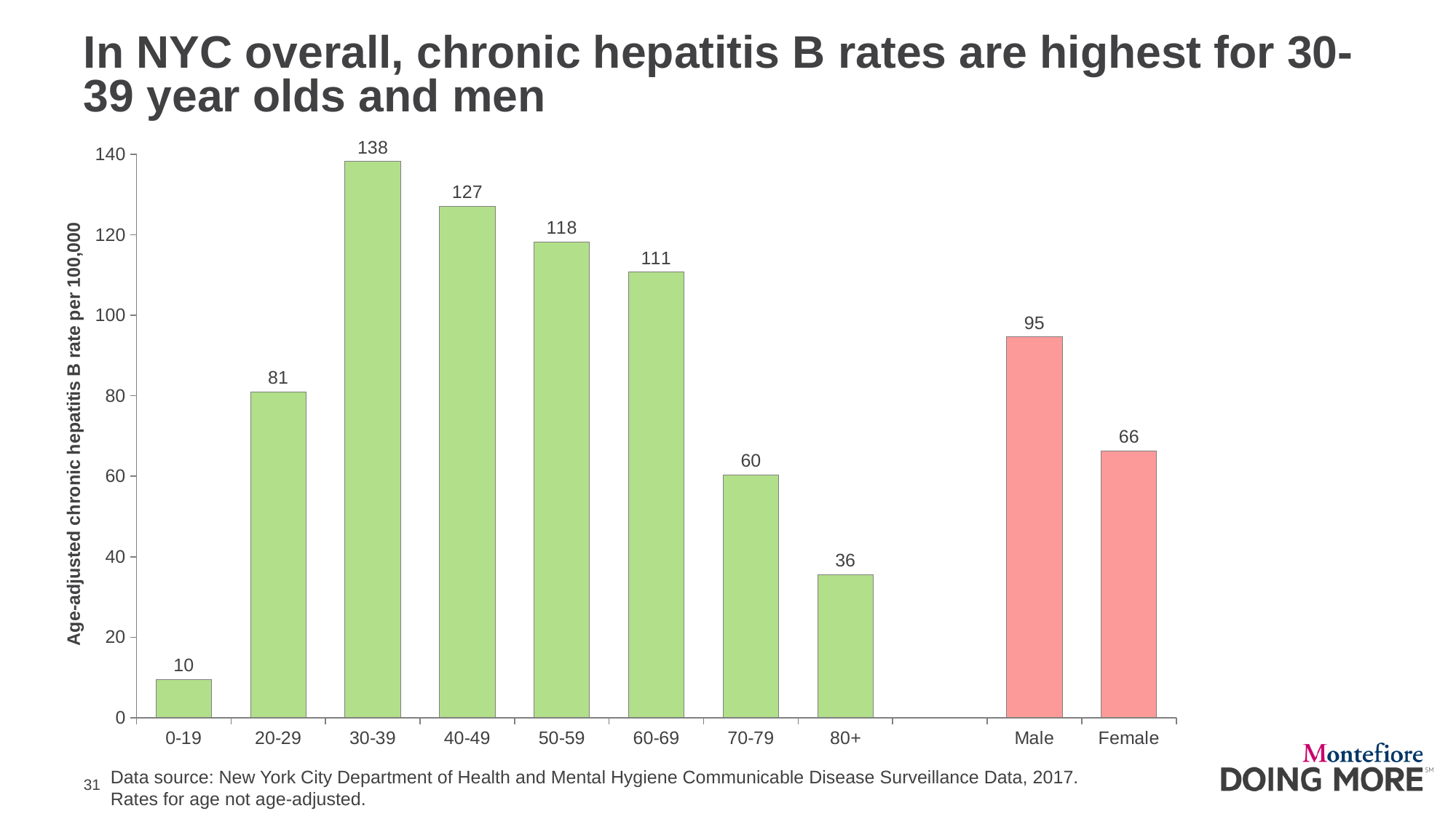
What is the chronic hepatitis B rate per 100,000 for males? 95 What is the difference between the male and female chronic hepatitis B rates? 29 What is the chronic hepatitis B rate per 100,000 for the 80+ age group? 36 What is the chronic hepatitis B rate per 100,000 for the 30-39 age group? 138 Which age group has the lowest chronic hepatitis B rate? 0-19 What kind of chart is shown on the slide? Bar chart Which age group has the highest chronic hepatitis B rate? 30-39 What is the label of the vertical axis? Age-adjusted chronic hepatitis B rate per 100,000 Is the value for the 60-69 age group greater or less than 100? greater What is the difference between the rates for the 30-39 and 40-49 age groups? 11 How many age groups are shown on the chart? 8 Which has a higher chronic hepatitis B rate, the 20-29 age group or the 70-79 age group? 20-29